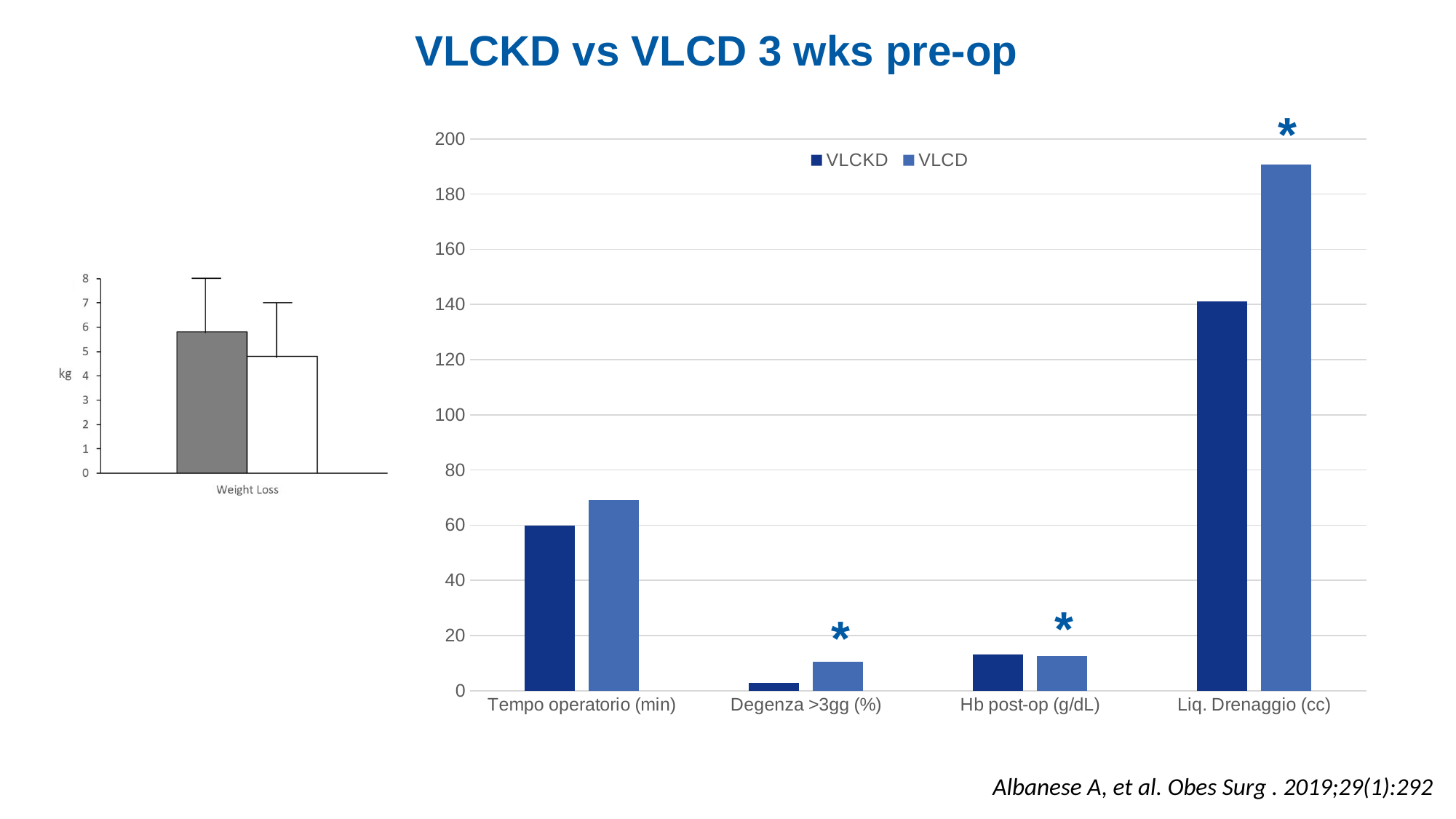
In the main chart on the right, which category has the lowest VLCKD bar? Degenza >3gg (%) In the main chart on the right, how many categories are shown on the x axis? 4 What kind of chart is the main chart on the right of the slide? bar chart In the main chart on the right, for Liq. Drenaggio (cc), which series has the larger value, VLCKD or VLCD? VLCD In the main chart on the right, is the VLCKD value for Liq. Drenaggio (cc) greater or less than 120? greater In the Weight Loss chart on the left, is the gray bar greater or less than 5 kg? greater In the main chart on the right, how many series does the legend list? 2 In the main chart on the right, is the VLCD value for Liq. Drenaggio (cc) greater or less than 180? greater In the Weight Loss chart on the left, is the gray bar or the white bar taller? gray bar In the main chart on the right, which category has the highest VLCD bar? Liq. Drenaggio (cc) In the main chart on the right, for Tempo operatorio (min), which series has the larger value, VLCKD or VLCD? VLCD